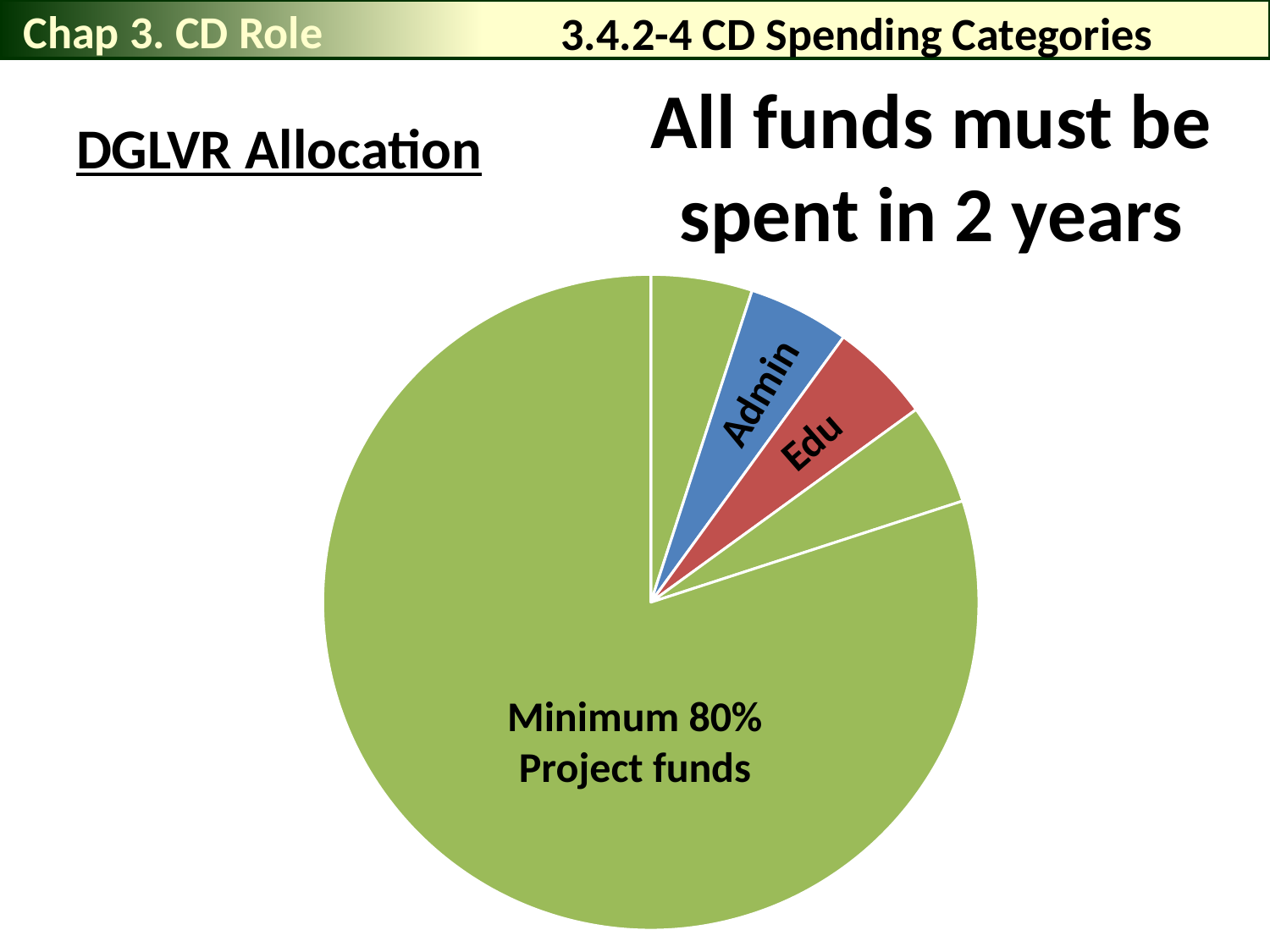
What is the title given to the pie chart on the slide? DGLVR Allocation Is the Edu slice larger or smaller than the Project funds slice? smaller Which slice of the pie chart is the largest? Minimum 80% Project funds What minimum share of the DGLVR allocation is labeled for Project funds? Minimum 80% Is the share for Admin greater or less than 20%? less Is the Project funds slice larger or smaller than the Admin slice? larger How many slices of the pie chart carry a text label? 3 What colour is the Admin slice of the pie chart? blue Is the share for Project funds greater or less than 50%? greater How many slices does the pie chart have? 5 What kind of chart is shown on the slide? pie chart What colour is the Edu slice of the pie chart? red